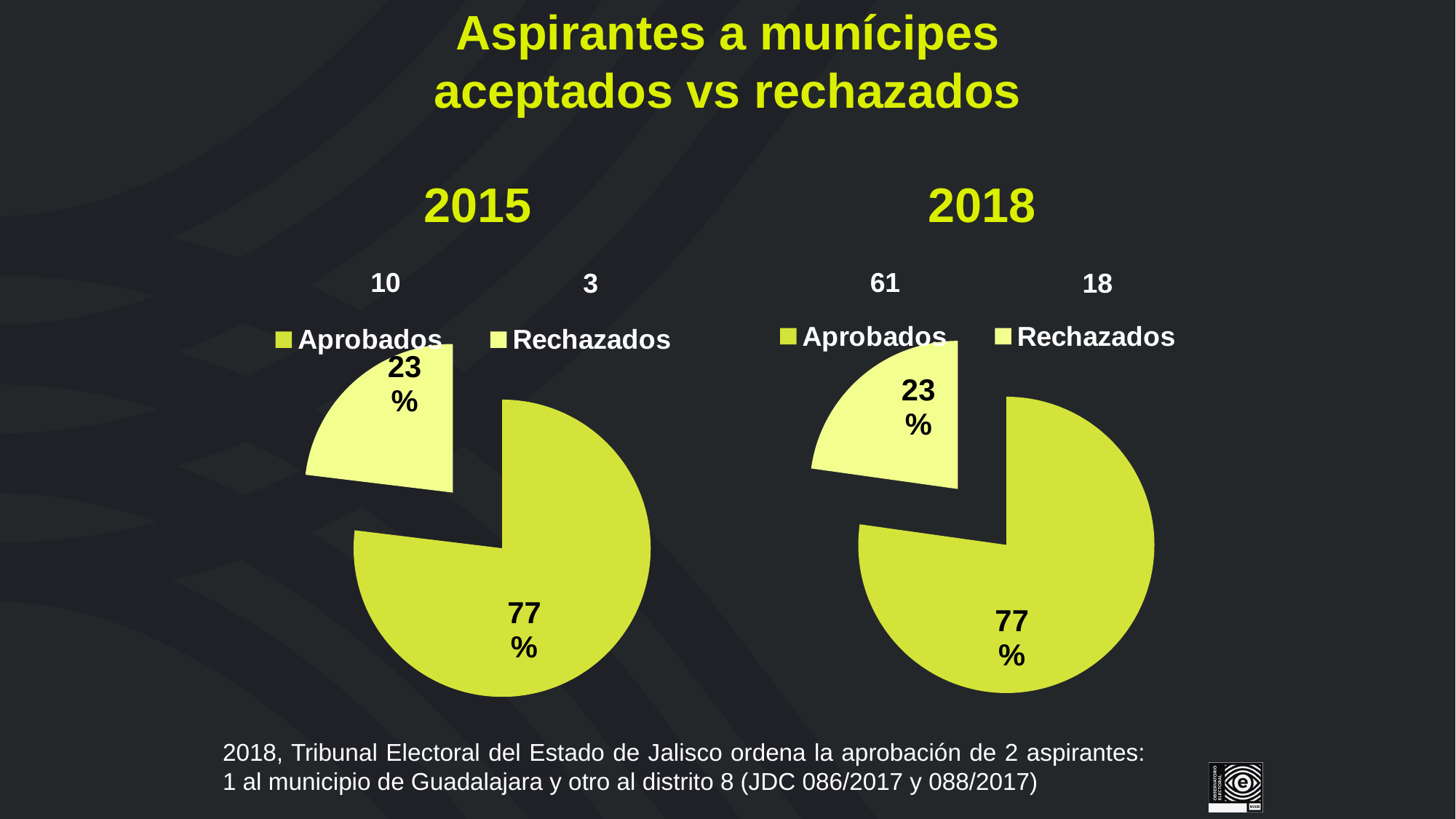
How many series does the legend of the 2015 chart list? 2 In the 2015 chart, what is the value for Rechazados? 3 In the 2018 chart, what is the difference between Aprobados and Rechazados? 43 In the 2018 chart, which category is the largest? Aprobados In the 2018 chart, what share of the pie is Rechazados? 23% Which is larger: Aprobados in 2015 or Rechazados in 2018? Rechazados in 2018 In the 2015 chart, what is the value for Aprobados? 10 In the 2015 chart, what share of the pie is Aprobados? 77% In the 2018 chart, what is the value for Rechazados? 18 In the 2015 chart, which category is the smallest? Rechazados What kind of chart is used for the 2015 data? pie chart In the 2018 chart, what is the value for Aprobados? 61